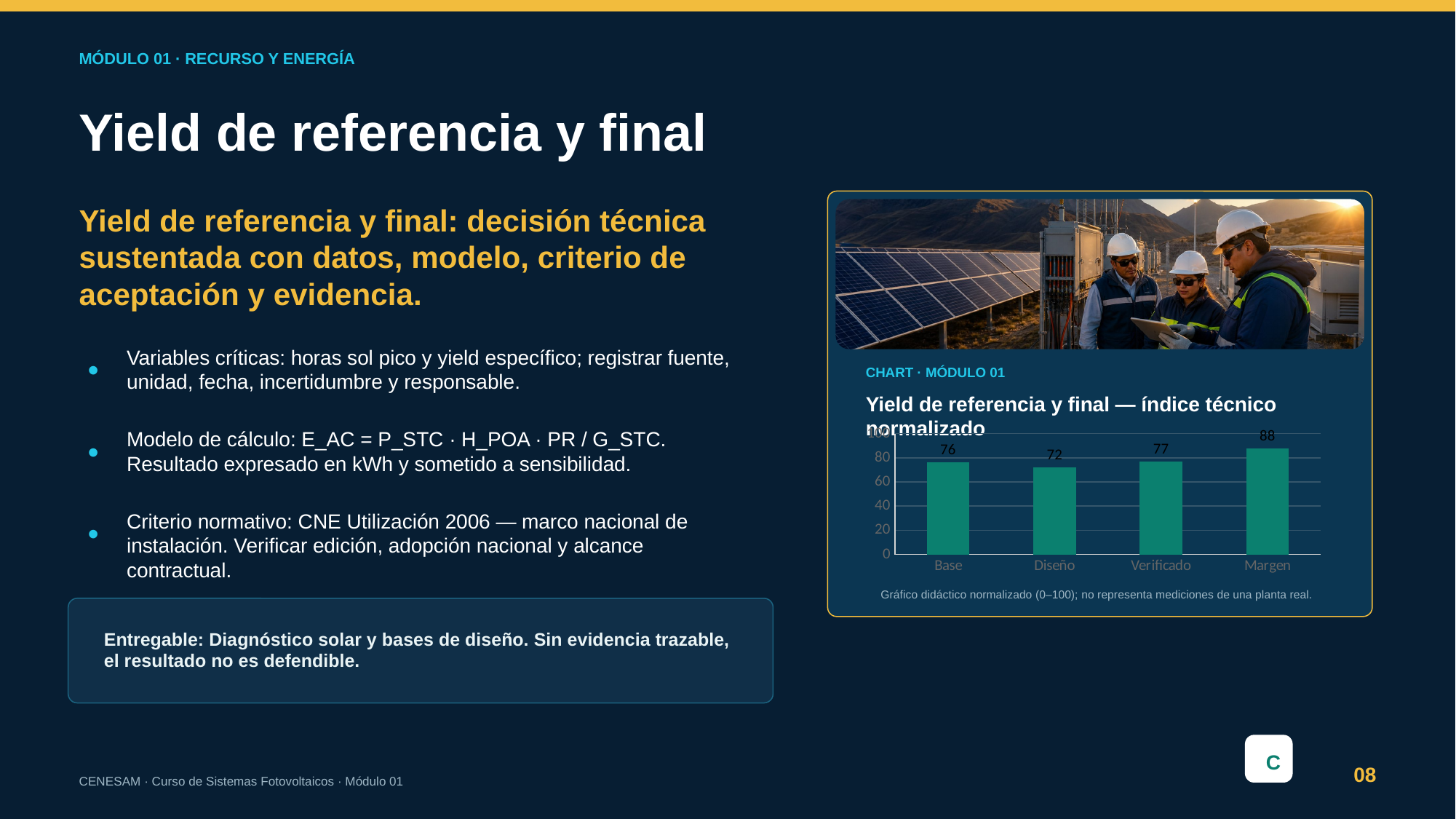
What is the difference between the values for Margen and Diseño? 16 What is the value for Margen? 88 What kind of chart is shown on the slide? bar chart What is the value for Base? 76 Which category has the lowest value? Diseño How many categories are shown on the x axis? 4 What is the difference between the values for Verificado and Base? 1 Is the value for Diseño greater or less than 80? less Which category has the highest value? Margen What is the value for Verificado? 77 What is the value for Diseño? 72 Which is larger, the value for Margen or the value for Base? Margen